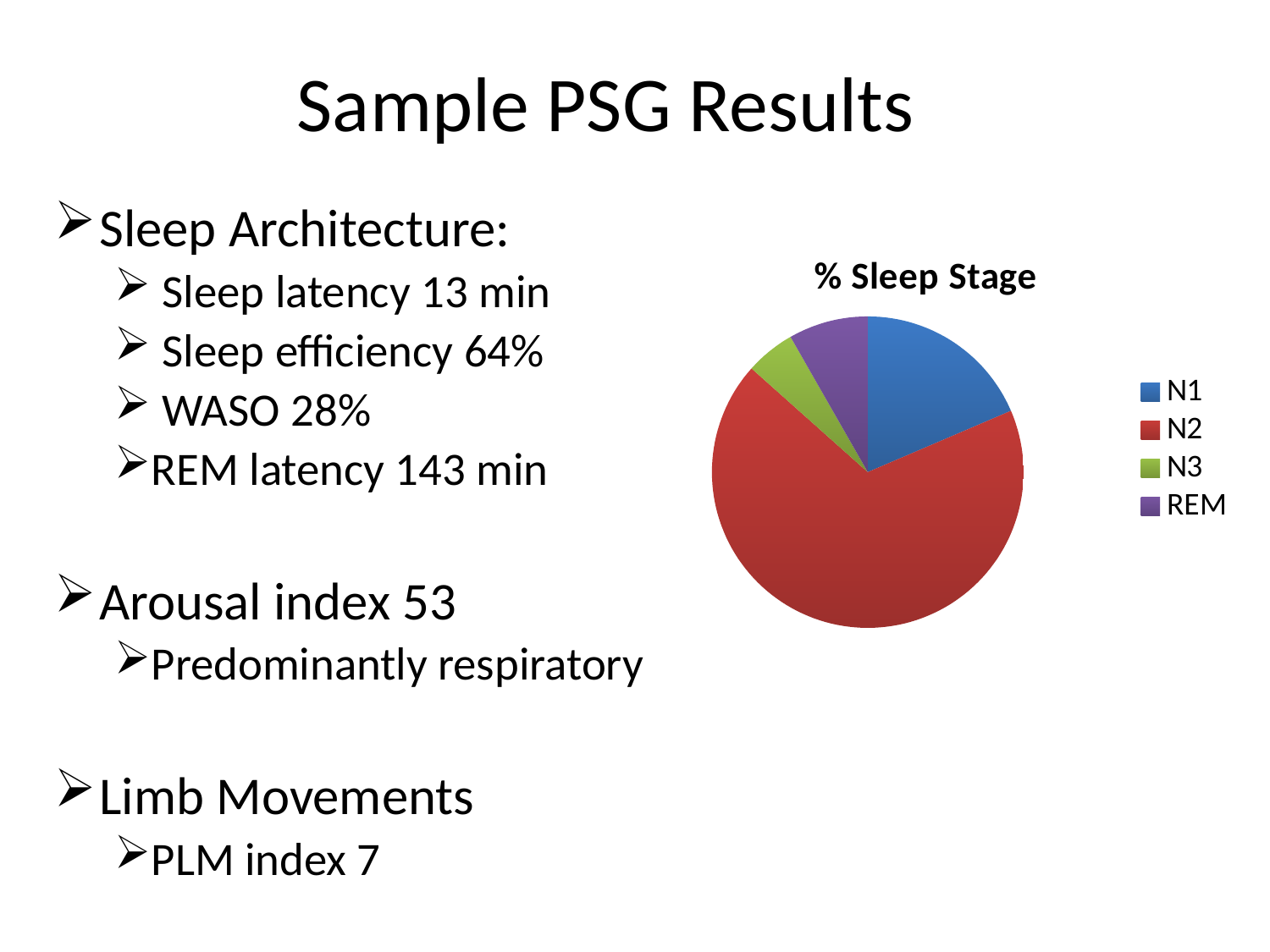
What colour represents N2 in the pie chart? red Which sleep stage has the smallest slice of the pie? N3 What is the title of the chart? % Sleep Stage Which slice is larger, N3 or N2? N2 Which sleep stage has the largest slice of the pie? N2 Which slice is larger, N1 or N2? N2 How many entries does the chart's legend list? 4 What kind of chart is shown on the slide? pie chart How many sleep stages (slices) does the pie chart show? 4 Which slice is larger, N1 or REM? N1 Which sleep stage is shown in green? N3